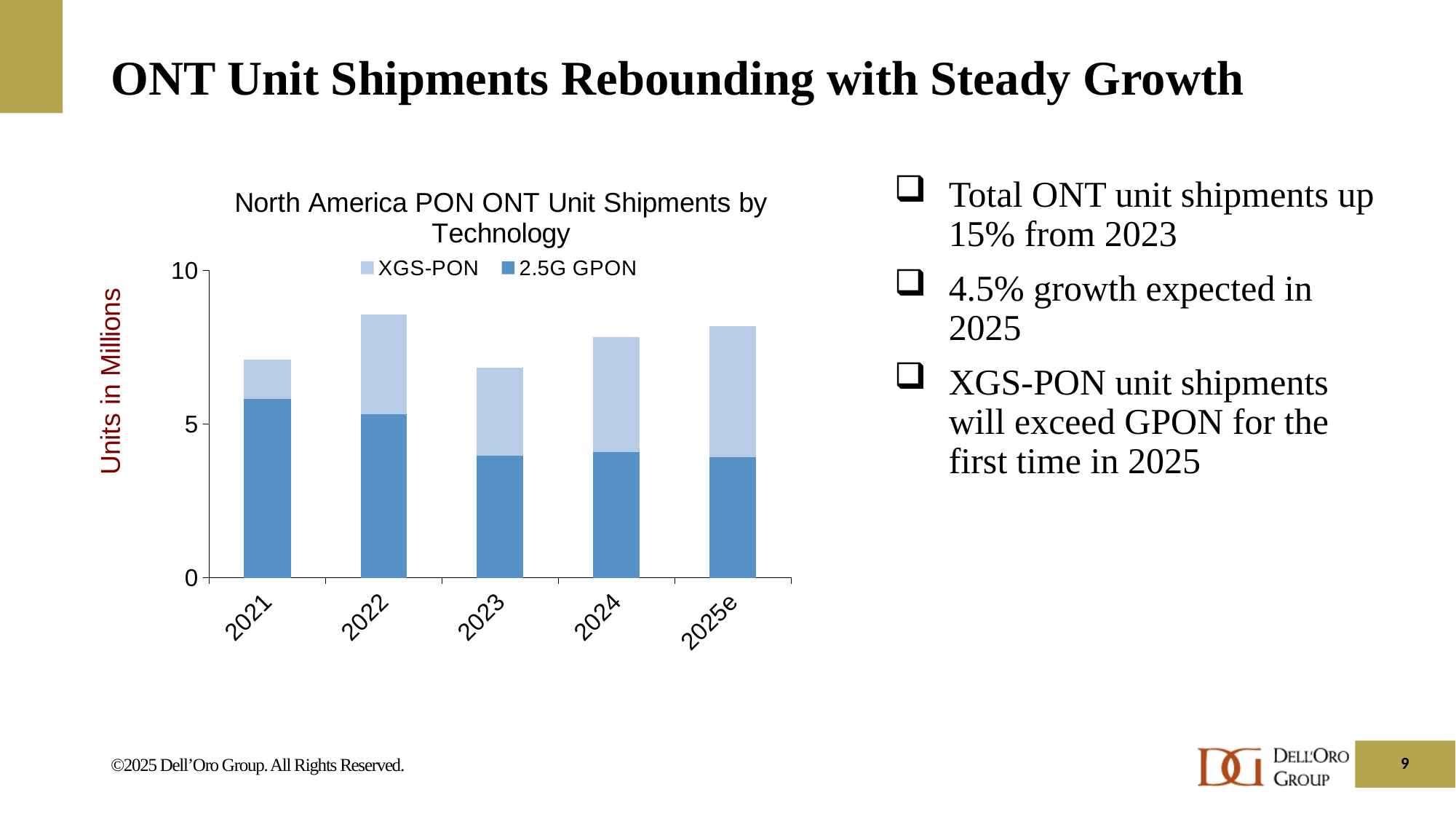
Which year has the shortest total stacked bar? 2023 Is the total stacked bar for 2022 greater or less than 5? greater Is the 2.5G GPON value for 2021 greater or less than 5? greater What is the label on the vertical axis of the chart? Units in Millions Is the 2.5G GPON segment larger in 2021 or in 2025e? 2021 How many years are shown on the x axis of the chart? 5 Is the 2.5G GPON value for 2023 greater or less than 5? less What is the title of the chart? North America PON ONT Unit Shipments by Technology How many series does the chart's legend list? 2 What kind of chart is shown on the slide? Stacked bar chart Which year has the tallest total stacked bar? 2022 Does the 2.5G GPON segment generally rise or fall from 2021 to 2025e? fall